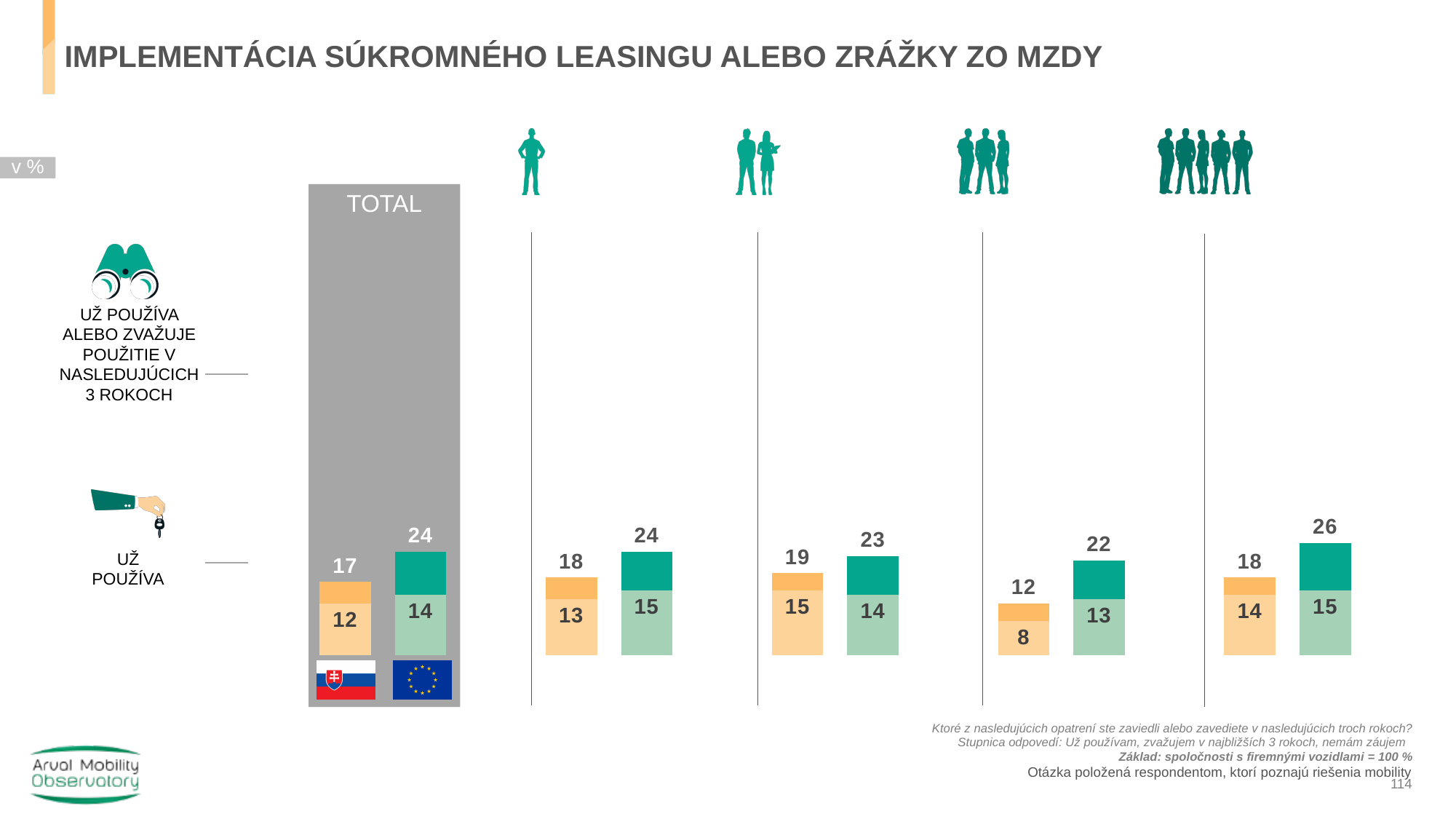
How many groups of bars are shown on the chart, including TOTAL? 5 In the group with the three-person icon, what is the "už používa" value for Slovakia (orange bar)? 8 In the group with the single-person icon, what is the "už používa alebo zvažuje" value for the EU (green bar)? 24 In the TOTAL section, what is the "už používa" value for the EU (green bar)? 14 In the TOTAL section, what is the difference between the EU value (24) and the Slovak value (17) for "už používa alebo zvažuje"? 7 What kind of chart is shown on the slide? Bar chart In what unit are the values on the chart expressed? % Among the EU (green) bars, which group has the highest "už používa alebo zvažuje" value? The rightmost group (five-person icon), 26 In the group with the two-person icon, which has the larger "už používa" value: Slovakia or the EU? Slovakia In the group with the five-person icon, what is the difference between the EU value (26) and the Slovak value (18) for "už používa alebo zvažuje"? 8 In the TOTAL section, what is the value for Slovakia (orange bar) for "už používa alebo zvažuje použitie v nasledujúcich 3 rokoch"? 17 Among the Slovak (orange) bars, which group has the lowest "už používa alebo zvažuje" value? The group with the three-person icon, 12